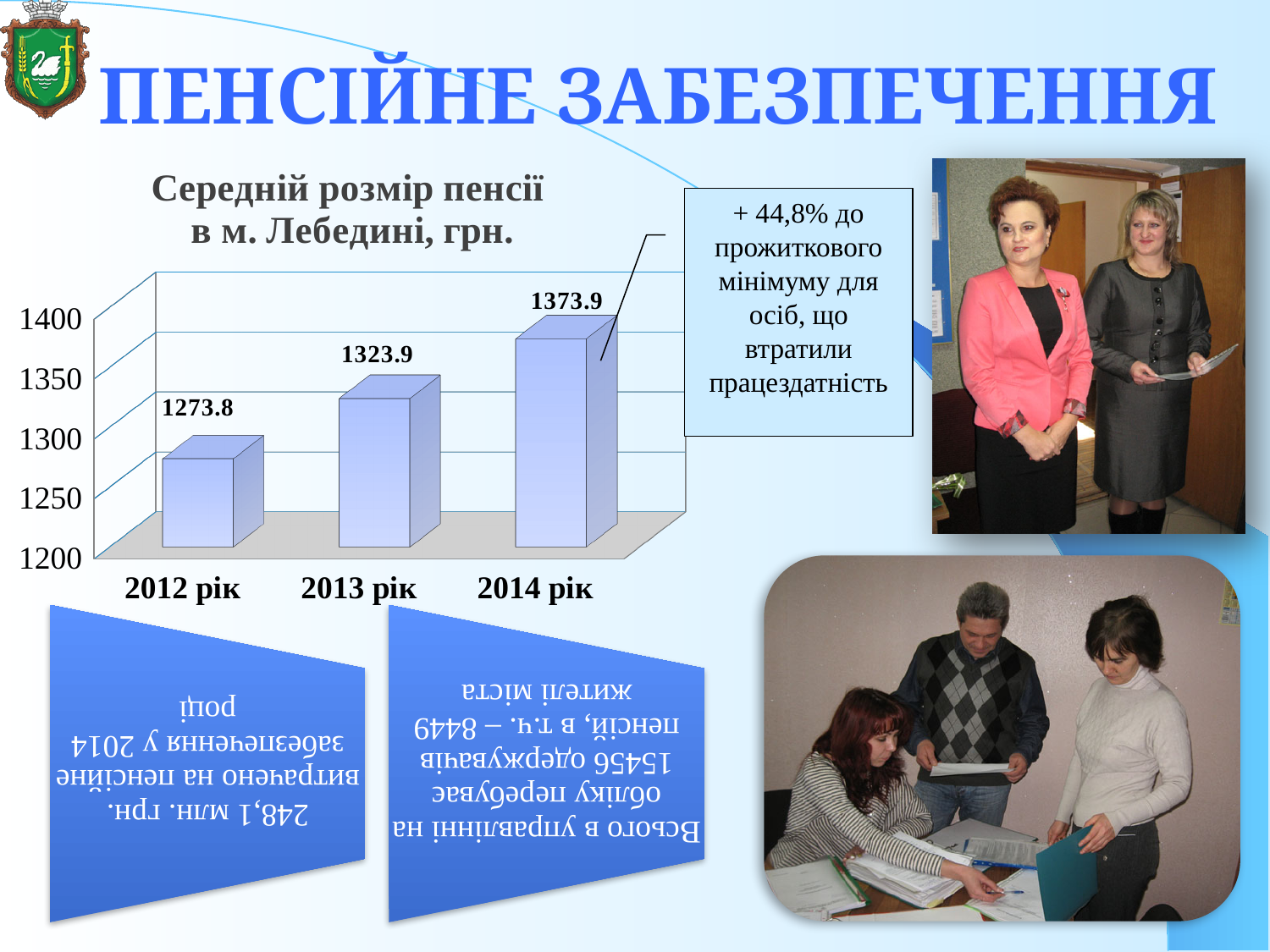
Which is larger, the average pension in 2013 рік or in 2014 рік? 2014 рік What is the average pension value shown for 2014 рік? 1373.9 What kind of chart is used to show the average pension? bar chart Is the value for 2012 рік greater or less than 1300? less What is the average pension value shown for 2012 рік? 1273.8 Which year has the lowest average pension on the chart? 2012 рік Which year has the highest average pension on the chart? 2014 рік What is the difference between the average pension in 2014 рік and 2012 рік? 100.1 How many years (categories) are shown on the chart? 3 What is the average pension value shown for 2013 рік? 1323.9 What is the difference between the average pension in 2013 рік and 2012 рік? 50.1 Do the average pension values rise or fall from 2012 рік to 2014 рік? rise